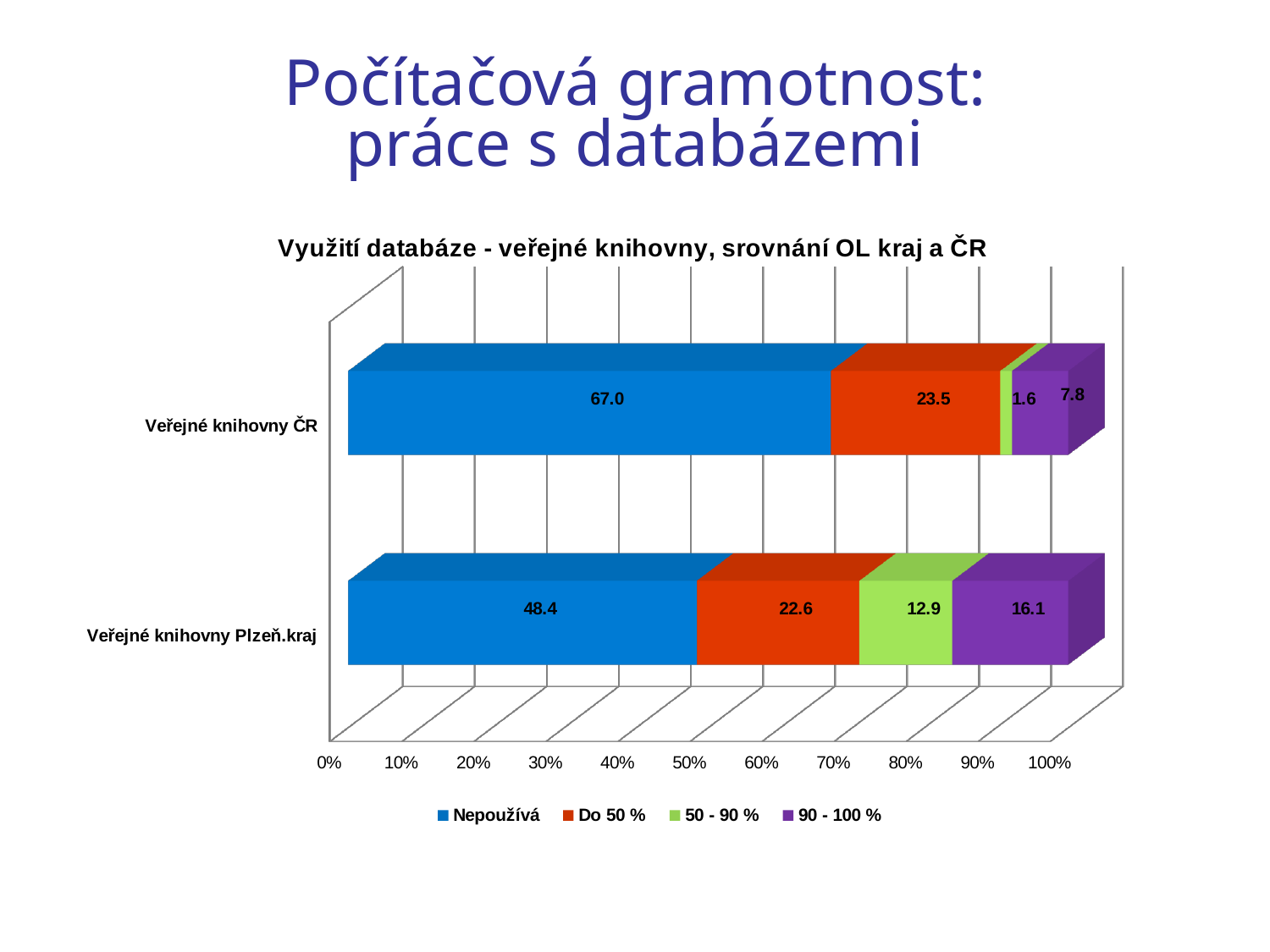
What is the value of the "Nepoužívá" segment for Veřejné knihovny ČR? 67.0 What type of chart is shown on the slide? Stacked bar chart Which category has the higher "Nepoužívá" value, Veřejné knihovny ČR or Veřejné knihovny Plzeň.kraj? Veřejné knihovny ČR Which series has the smallest segment in the Veřejné knihovny ČR bar? 50 - 90 % What is the value of the "50 - 90 %" segment for Veřejné knihovny ČR? 1.6 Which series has the largest segment in the Veřejné knihovny Plzeň.kraj bar? Nepoužívá What is the value of the "Do 50 %" segment for Veřejné knihovny Plzeň.kraj? 22.6 How many series does the legend list? 4 What is the difference between the "50 - 90 %" values for Veřejné knihovny Plzeň.kraj and Veřejné knihovny ČR? 11.3 What is the value of the "90 - 100 %" segment for Veřejné knihovny Plzeň.kraj? 16.1 How many categories are shown on the chart? 2 What is the difference between the "Nepoužívá" values for Veřejné knihovny ČR and Veřejné knihovny Plzeň.kraj? 18.6